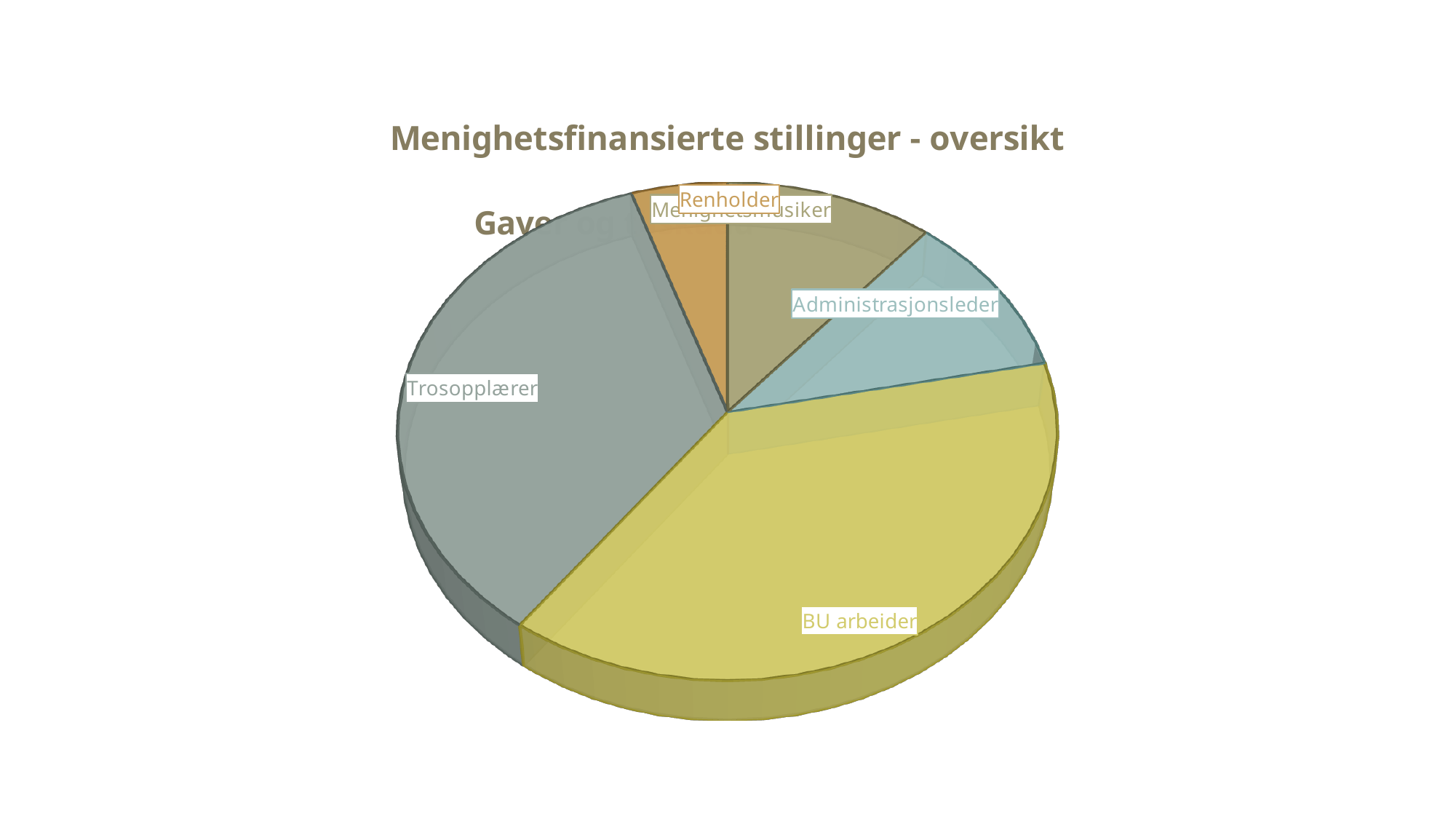
Which slice is larger, Trosopplærer or Administrasjonsleder? Trosopplærer What is the title of the chart? Menighetsfinansierte stillinger - oversikt Which slice is larger, BU arbeider or Menighetsmusiker? BU arbeider What colour is the BU arbeider slice? Yellow Which slice is larger, BU arbeider or Trosopplærer? BU arbeider Which category has the largest slice of the pie? BU arbeider Which category has the second-largest slice of the pie? Trosopplærer Which category has the smallest slice of the pie? Renholder How many slices does the pie chart have? 5 What kind of chart is shown on the slide? Pie chart